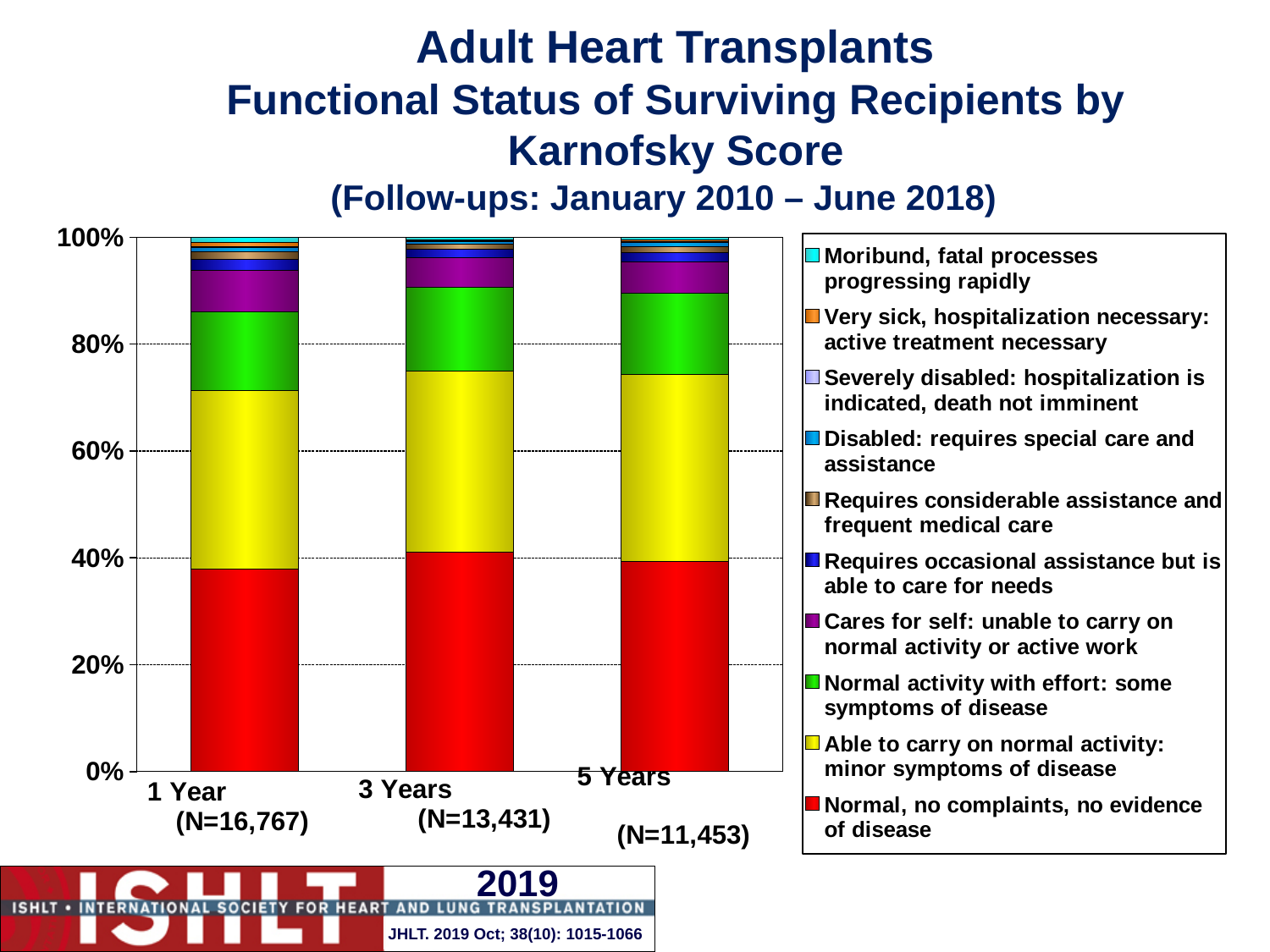
Is the share of 'Normal, no complaints, no evidence of disease' at 1 Year greater or less than 40%? less Which has the larger 'Cares for self: unable to carry on normal activity or active work' share, 1 Year or 3 Years? 1 Year Is the combined share of the 'Normal, no complaints' and 'Able to carry on normal activity' categories at 3 Years greater or less than 60%? greater What kind of chart is shown on the slide? stacked bar chart What total does each stacked bar reach on the y axis? 100% What is the N value shown for the 1 Year follow-up? N=16,767 How many follow-up time points (bars) are shown on the x axis? 3 What is the N value shown for the 5 Years follow-up? N=11,453 Which colour represents 'Normal, no complaints, no evidence of disease' in the legend? red Is the combined share of the bottom three categories (red, yellow and green) at 1 Year greater or less than 80%? greater How many Karnofsky score categories does the legend list? 10 Which follow-up time point has the largest N? 1 Year